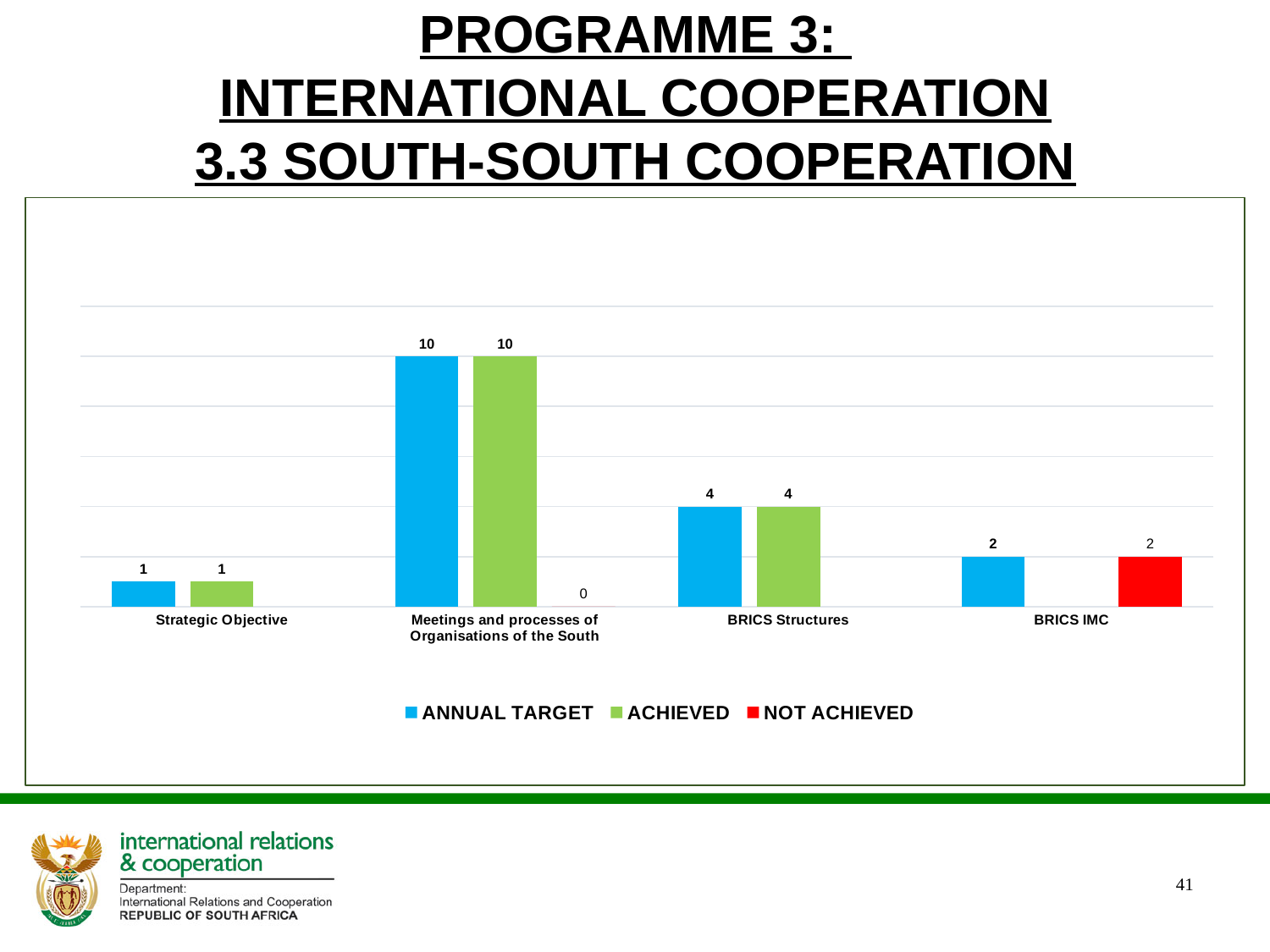
What is the ACHIEVED value for BRICS Structures? 4 What is the ANNUAL TARGET value for Meetings and processes of Organisations of the South? 10 How many categories are shown on the x axis? 4 What is the ANNUAL TARGET value for Strategic Objective? 1 What is the NOT ACHIEVED value for Meetings and processes of Organisations of the South? 0 Which category has the lowest ANNUAL TARGET value? Strategic Objective What kind of chart is shown on the slide? Bar chart How many series does the legend list? 3 Which is larger: the ANNUAL TARGET for BRICS Structures or the ANNUAL TARGET for BRICS IMC? BRICS Structures Which category has the highest ANNUAL TARGET value? Meetings and processes of Organisations of the South What is the difference between the ANNUAL TARGET for Meetings and processes of Organisations of the South and the ANNUAL TARGET for BRICS Structures? 6 What is the NOT ACHIEVED value for BRICS IMC? 2